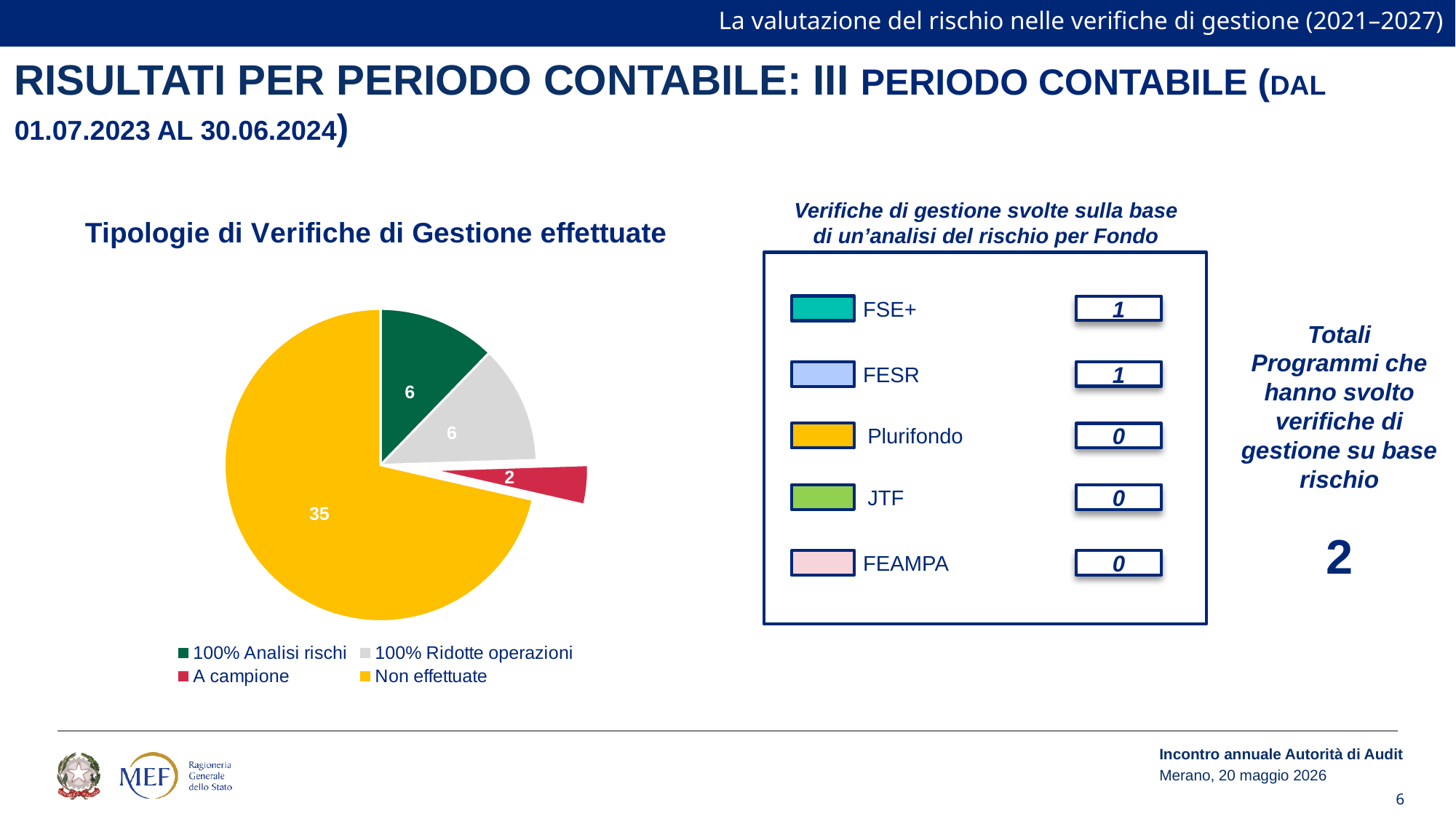
What is the total of all the values shown in the pie chart? 49 In the pie chart, what is the difference between the values for "Non effettuate" and "A campione"? 33 In the pie chart, what is the value for "100% Ridotte operazioni"? 6 How many categories does the pie chart's legend list? 4 In the pie chart, which is larger: "100% Analisi rischi" or "A campione"? 100% Analisi rischi Which category has the largest slice in the pie chart? Non effettuate In the pie chart, what is the value for "100% Analisi rischi"? 6 Which category has the smallest slice in the pie chart? A campione What kind of chart is shown under the title "Tipologie di Verifiche di Gestione effettuate"? Pie chart What colour is the "Non effettuate" slice in the pie chart? Yellow In the pie chart, what is the value for "Non effettuate"? 35 In the pie chart, what is the value for "A campione"? 2